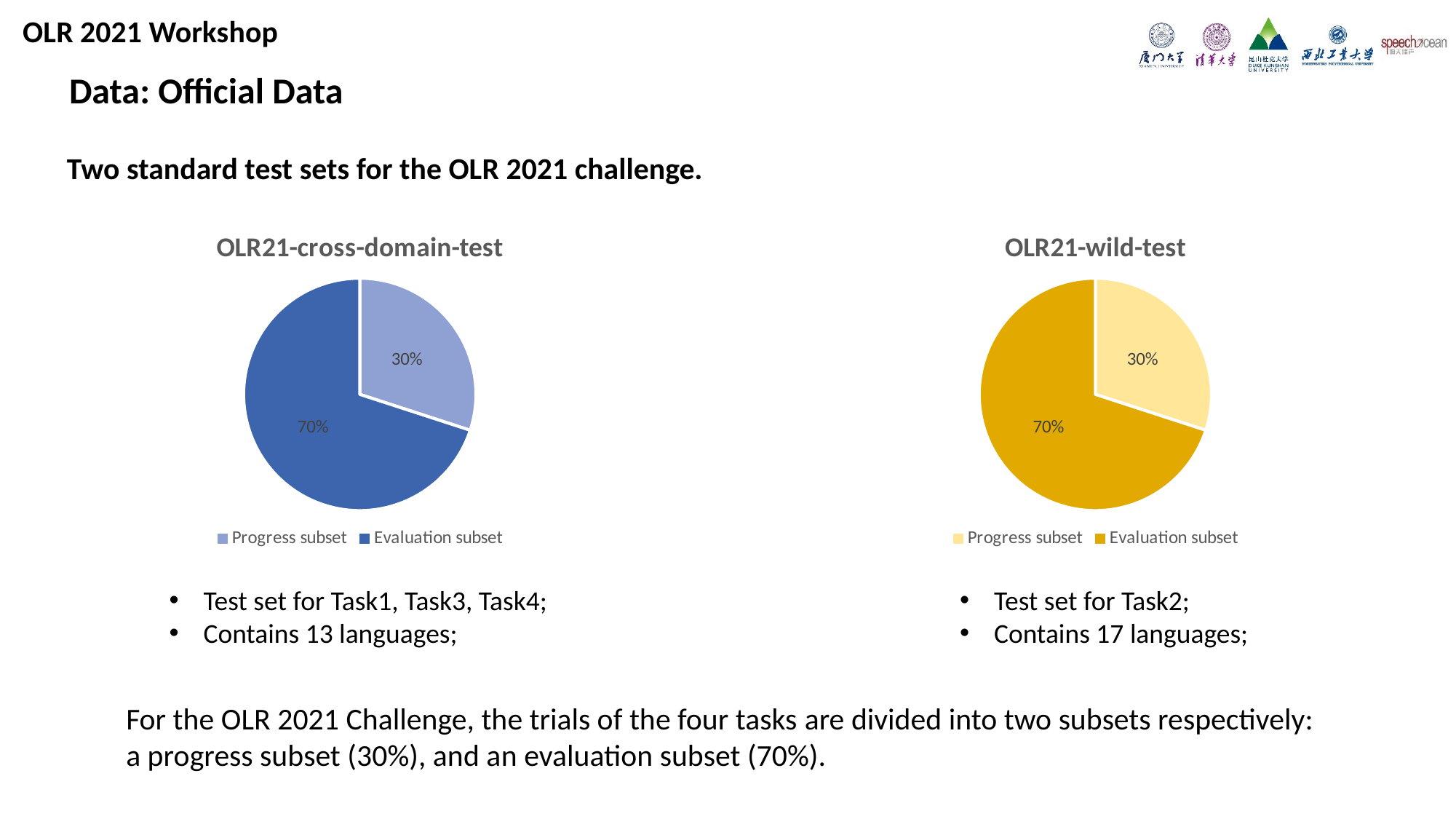
In the OLR21-cross-domain-test chart, which subset has the largest slice? Evaluation subset In the OLR21-wild-test chart, what share does the Progress subset have? 30% In the OLR21-wild-test chart, what share does the Evaluation subset have? 70% How many slices does the OLR21-wild-test pie chart have? 2 What is the title of the pie chart on the right side of the slide? OLR21-wild-test In the OLR21-cross-domain-test chart, what is the difference in percentage points between the Evaluation subset and the Progress subset? 40 In the OLR21-cross-domain-test chart, what share does the Progress subset have? 30% How many entries does the legend of the OLR21-cross-domain-test chart list? 2 In the OLR21-wild-test chart, which is larger, the Progress subset or the Evaluation subset? Evaluation subset In the OLR21-cross-domain-test chart, what share does the Evaluation subset have? 70% What kind of chart is the OLR21-cross-domain-test chart? Pie chart In the OLR21-wild-test chart, which subset has the smallest slice? Progress subset